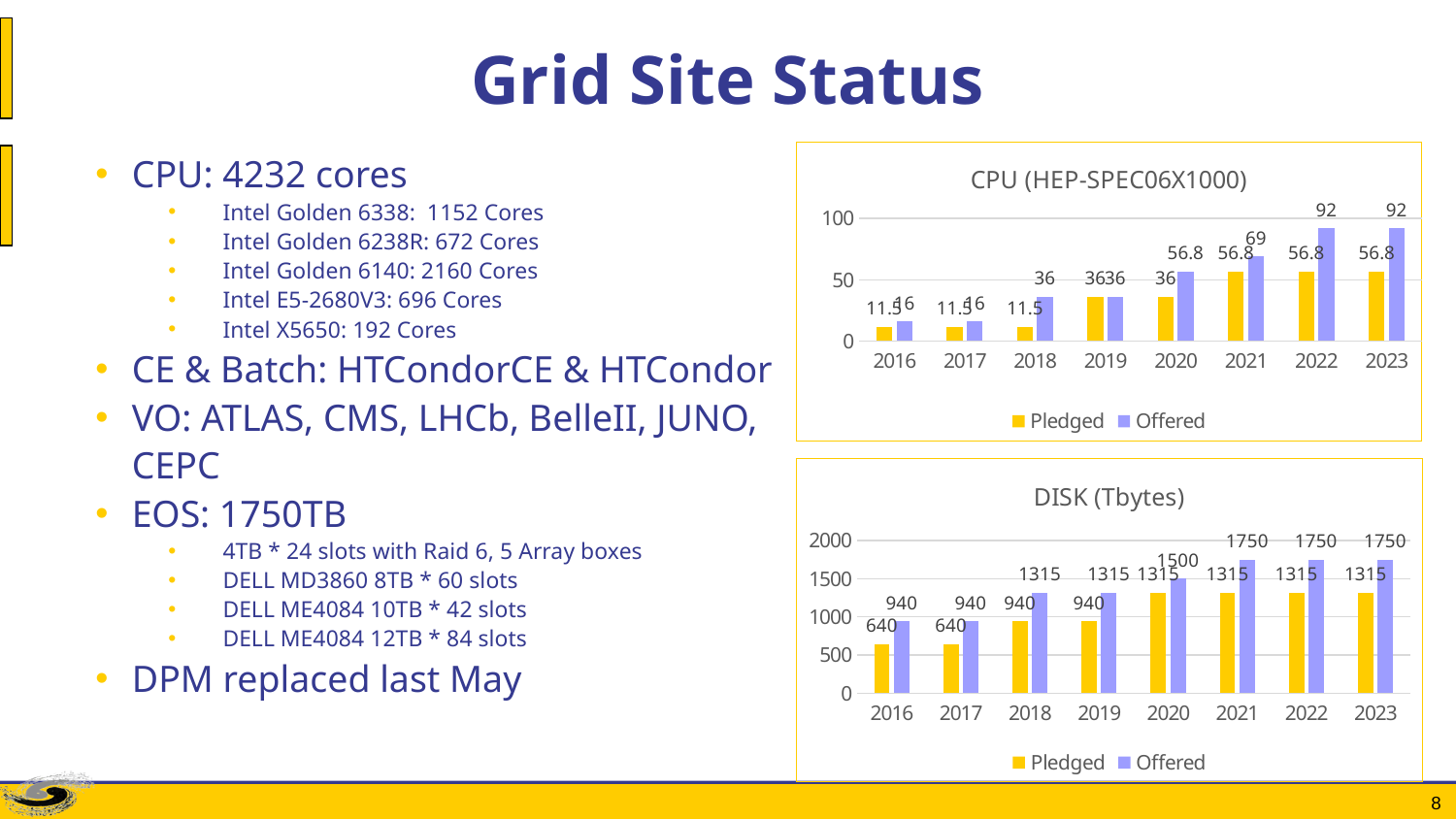
In the DISK (Tbytes) chart, what is the Pledged value for 2016? 640 In the DISK (Tbytes) chart, how many years are shown on the x axis? 8 In the DISK (Tbytes) chart, which is larger: the Pledged value for 2020 or the Offered value for 2019? They are equal (1315) In the DISK (Tbytes) chart, what is the difference between the Offered and Pledged values for 2023? 435 What kind of chart is the DISK (Tbytes) chart? Bar chart In the CPU (HEP-SPEC06X1000) chart, how many series does the legend list? 2 In the DISK (Tbytes) chart, what is the Offered value for 2020? 1500 In the CPU (HEP-SPEC06X1000) chart, is the Offered value for 2020 greater or less than 50? greater In the CPU (HEP-SPEC06X1000) chart, what is the difference between the Offered and Pledged values for 2022? 35.2 In the CPU (HEP-SPEC06X1000) chart, which year has the lowest Pledged value? 2016, 2017 and 2018 (all 11.5) In the CPU (HEP-SPEC06X1000) chart, what is the Offered value for 2021? 69 In the CPU (HEP-SPEC06X1000) chart, what is the Pledged value for 2023? 56.8